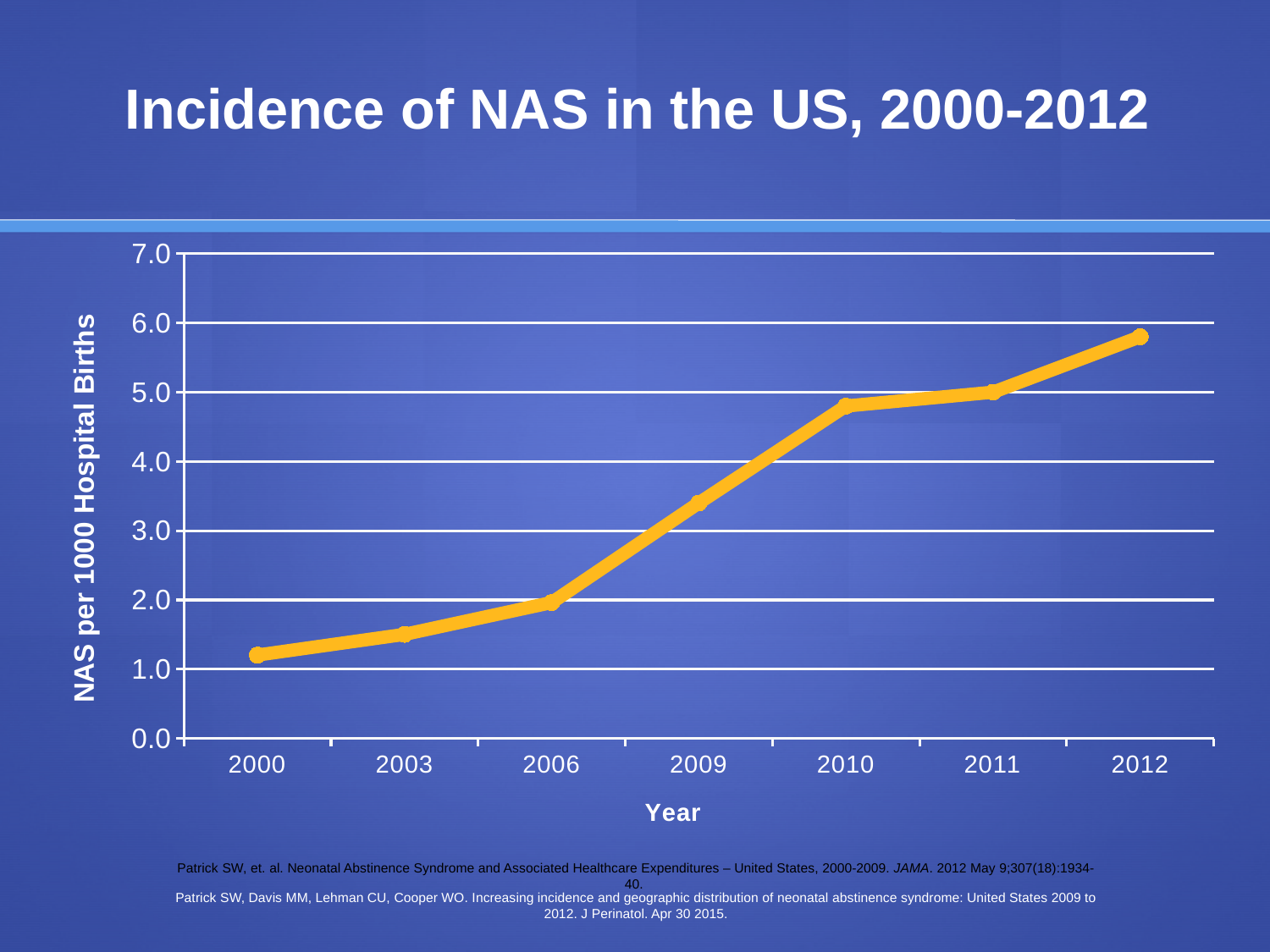
Is the value for 2000 greater or less than 2.0? less What kind of chart is shown on the slide? line chart Is the value for 2009 greater or less than 3.0? greater What is the title of the chart? Incidence of NAS in the US, 2000-2012 Is the value for 2003 greater or less than 2.0? less Which year has the lowest NAS per 1000 hospital births? 2000 Do the values rise or fall from 2000 to 2012? rise Which year has the highest NAS per 1000 hospital births? 2012 How many years are plotted on the x axis? 7 What is the label on the y axis? NAS per 1000 Hospital Births Which year has the larger value, 2006 or 2009? 2009